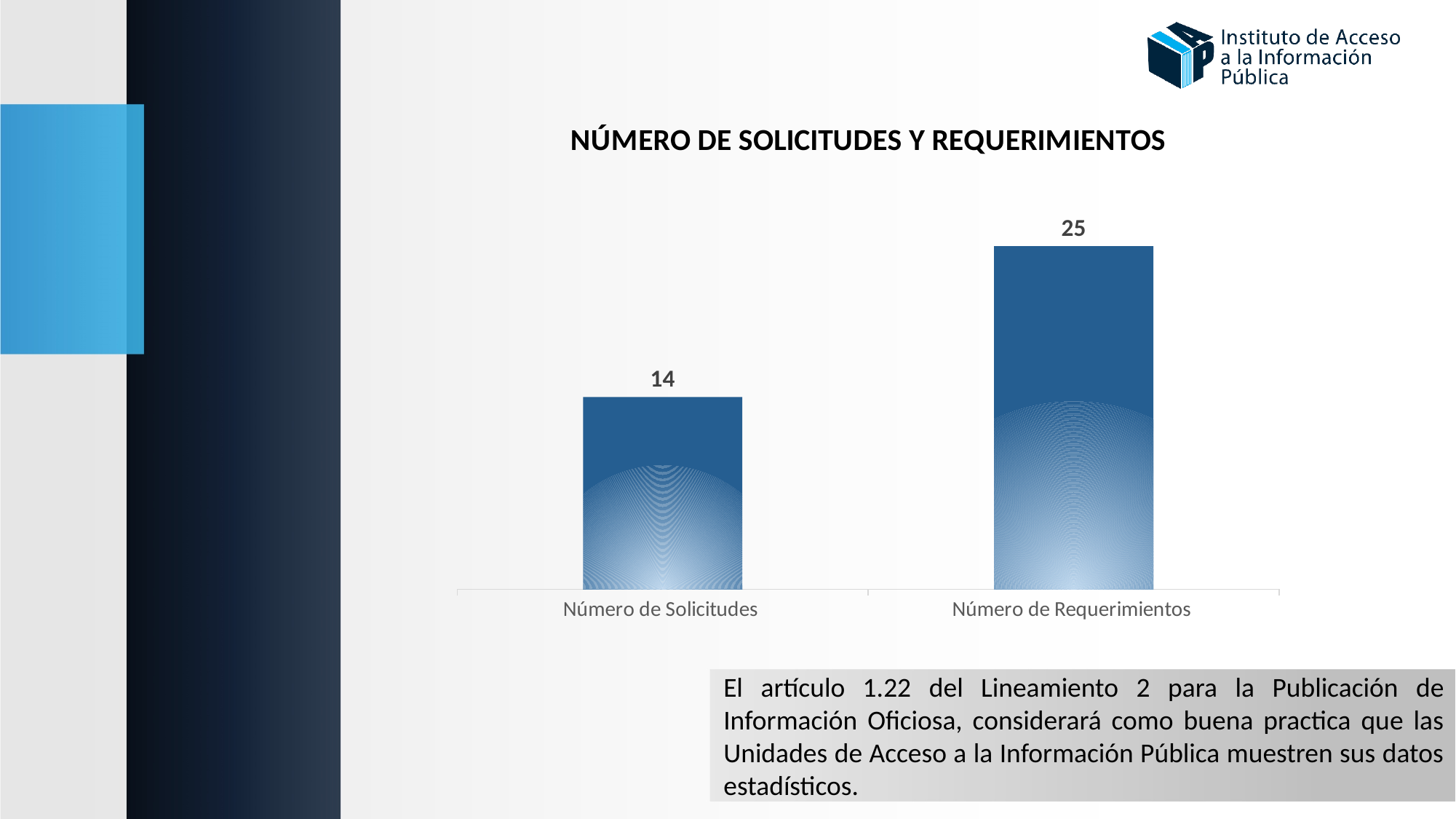
What is the difference between Número de Requerimientos and Número de Solicitudes? 11 Which is larger, Número de Solicitudes or Número de Requerimientos? Número de Requerimientos What is the value for Número de Solicitudes? 14 What colour are the bars in the chart? Blue What is the title of the chart? NÚMERO DE SOLICITUDES Y REQUERIMIENTOS Which category has the lowest value? Número de Solicitudes How many categories are shown in the chart? 2 What is the total of the two values shown in the chart? 39 What kind of chart is shown on the slide? Bar chart What is the value for Número de Requerimientos? 25 Which category has the highest value? Número de Requerimientos